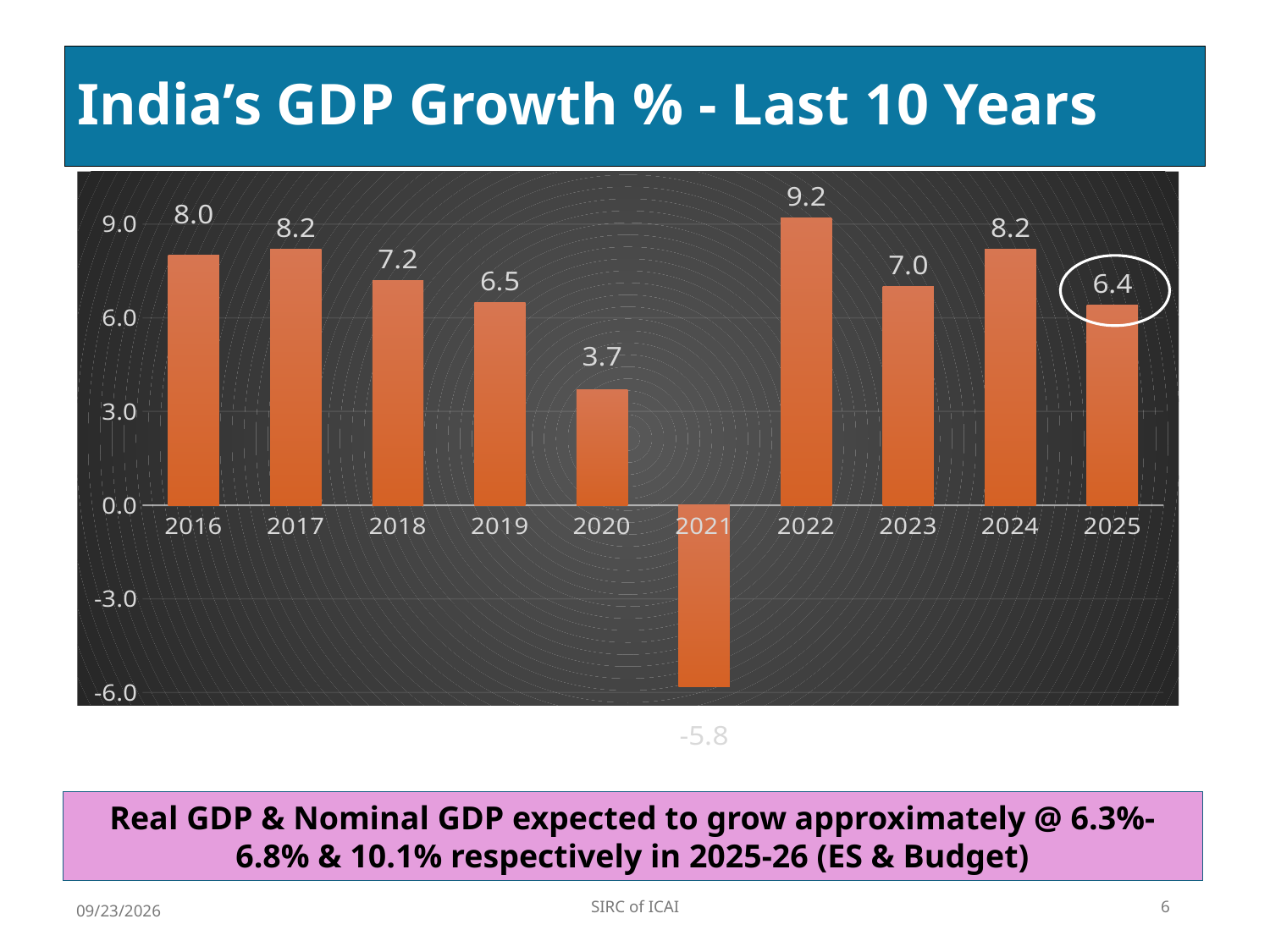
What is the difference between the GDP growth % in 2022 and 2023? 2.2 Does the GDP growth % rise or fall from 2022 to 2023? Fall Which year has the highest GDP growth %? 2022 Is the value for 2020 greater or less than 6.0? less What kind of chart is shown on the slide? Bar chart Which year has a higher GDP growth %, 2018 or 2019? 2018 What is India's GDP growth % for 2025? 6.4 What is the title of the slide's chart? India's GDP Growth % - Last 10 Years How many years are shown on the chart? 10 What is India's GDP growth % for 2021? -5.8 Which year has the lowest GDP growth %? 2021 What is India's GDP growth % for 2022? 9.2